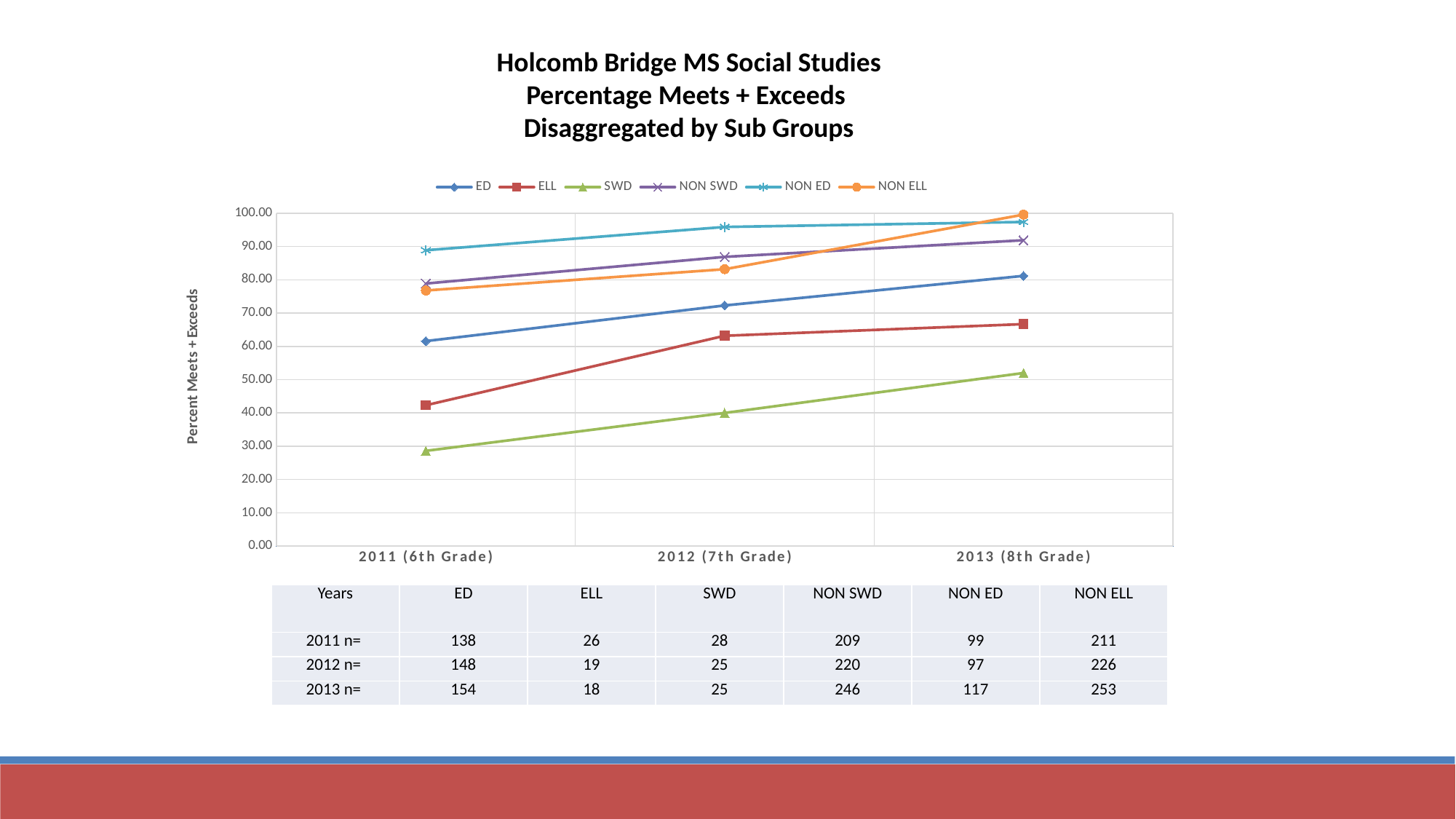
Is the value for ELL in 2011 (6th Grade) greater or less than 50? less Is the value for ED in 2013 (8th Grade) greater or less than 70? greater Which series has the highest value in 2011 (6th Grade)? NON ED Is the value for SWD in 2011 (6th Grade) greater or less than 40? less In 2012 (7th Grade), which is larger, the value for ED or the value for ELL? ED What is the title of the chart's vertical axis? Percent Meets + Exceeds How many points are plotted along the x axis for each series? 3 Which series has the lowest value in 2013 (8th Grade)? SWD How many series does the chart legend list? 6 Do the values for SWD rise or fall from 2011 (6th Grade) to 2013 (8th Grade)? rise What kind of chart is shown on the slide? line chart